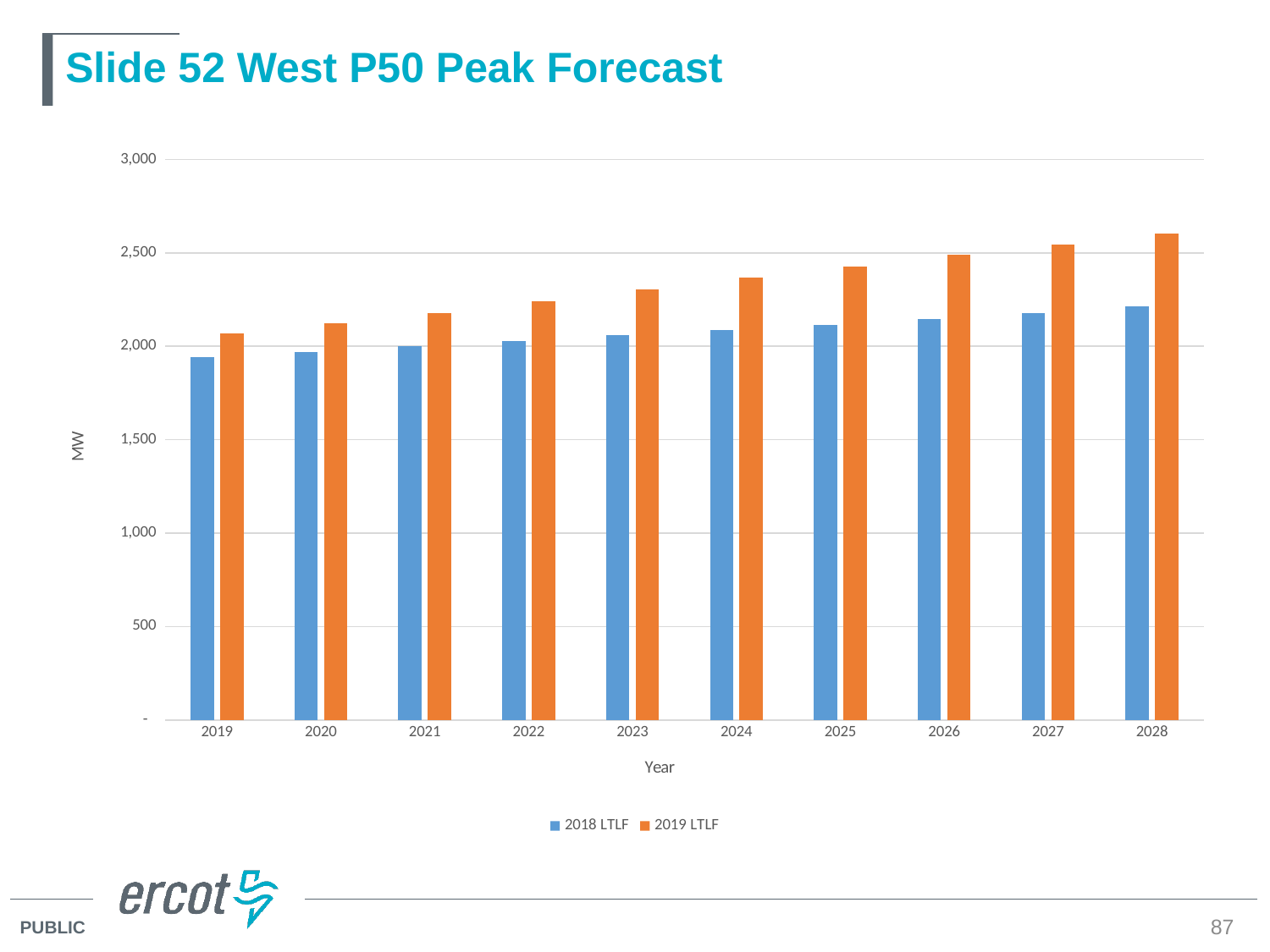
How many series does the legend list? 2 In 2025, which series has the larger value, 2018 LTLF or 2019 LTLF? 2019 LTLF Is the 2019 LTLF value for 2024 greater or less than 2,500? less Do the 2019 LTLF values rise or fall from 2019 to 2028? Rise Which series is shown in orange? 2019 LTLF What kind of chart is shown on the slide? Bar chart Is the 2019 LTLF value for 2028 greater or less than 2,500? greater Which year has the highest 2019 LTLF value? 2028 Which year has the lowest 2018 LTLF value? 2019 Is the 2018 LTLF value for 2019 greater or less than 2,000? less What is the label on the y axis? MW How many years are shown on the x axis? 10